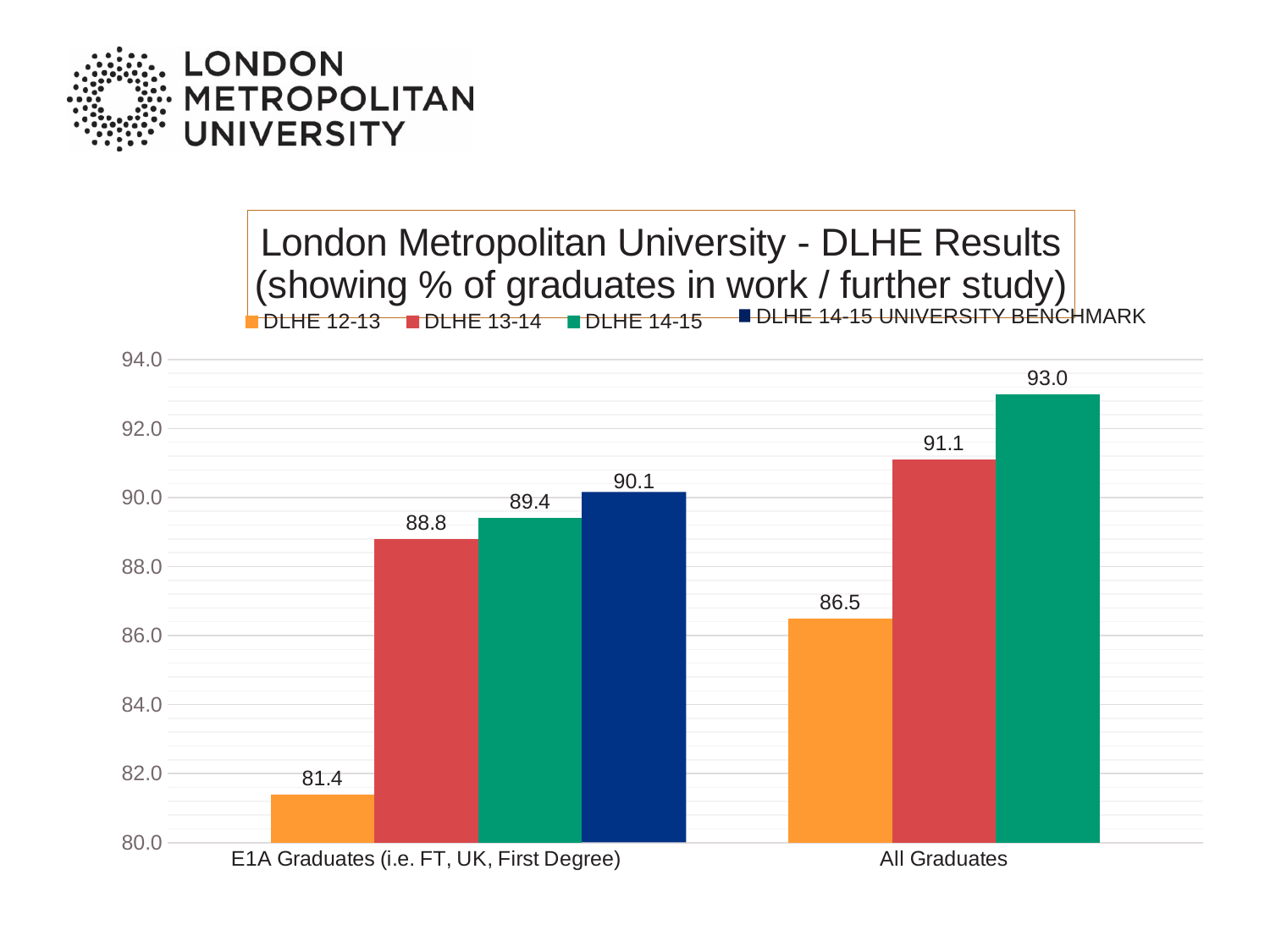
How many series does the legend list? 4 Which is larger for E1A Graduates (i.e. FT, UK, First Degree): DLHE 13-14 or DLHE 14-15? DLHE 14-15 What is the DLHE 12-13 value for E1A Graduates (i.e. FT, UK, First Degree)? 81.4 Which series has the highest value for All Graduates? DLHE 14-15 How many categories are shown on the x axis? 2 What is the difference between the DLHE 14-15 and DLHE 12-13 values for All Graduates? 6.5 What is the DLHE 14-15 value for All Graduates? 93.0 Which series is shown in dark blue in the legend? DLHE 14-15 UNIVERSITY BENCHMARK Which series has the lowest value for E1A Graduates (i.e. FT, UK, First Degree)? DLHE 12-13 What is the DLHE 13-14 value for All Graduates? 91.1 What kind of chart is shown on the slide? Bar chart What is the DLHE 14-15 UNIVERSITY BENCHMARK value for E1A Graduates (i.e. FT, UK, First Degree)? 90.1